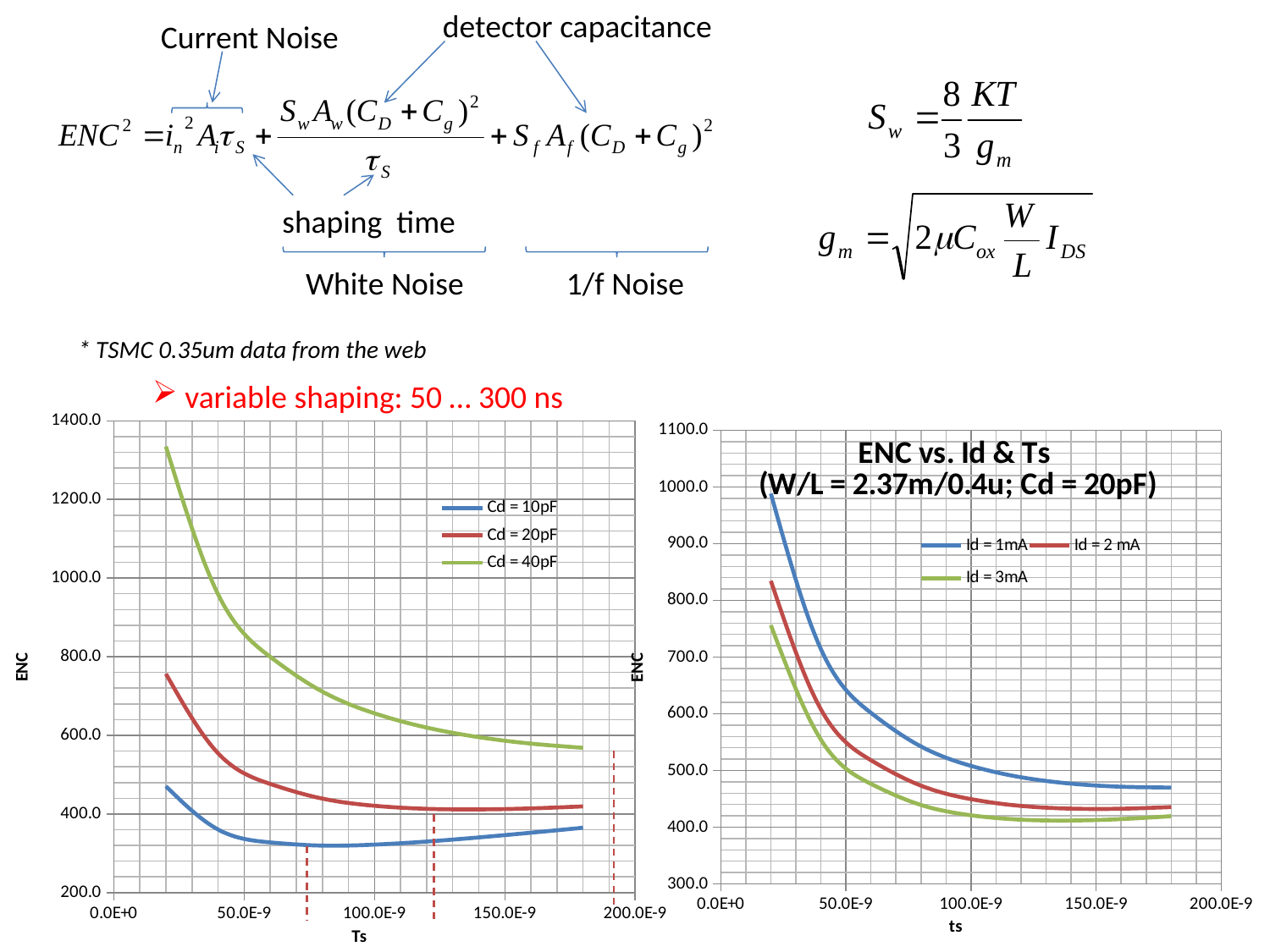
In the left chart, which series has the lowest ENC values across the plotted range? Cd = 10pF What kind of chart is the left chart on the slide? line chart How many series does the legend of the left chart list? 3 In the right chart, at the smallest plotted ts, which series has the larger ENC: Id = 2 mA or Id = 3mA? Id = 2 mA In the left chart, which series has the highest ENC values across the plotted range? Cd = 40pF In the right chart, which series has the lowest ENC values across the plotted range? Id = 3mA In the left chart, does the Cd = 40pF series rise or fall as Ts increases? fall In the right chart, is the starting value of the Id = 1mA series greater or less than 900.0? greater How many series does the legend of the right chart list? 3 What is the title of the right chart? ENC vs. Id & Ts (W/L = 2.37m/0.4u; Cd = 20pF) In the left chart, is the starting value of the Cd = 10pF series greater or less than 600.0? less In the left chart, is the starting value of the Cd = 40pF series greater or less than 1200.0? greater